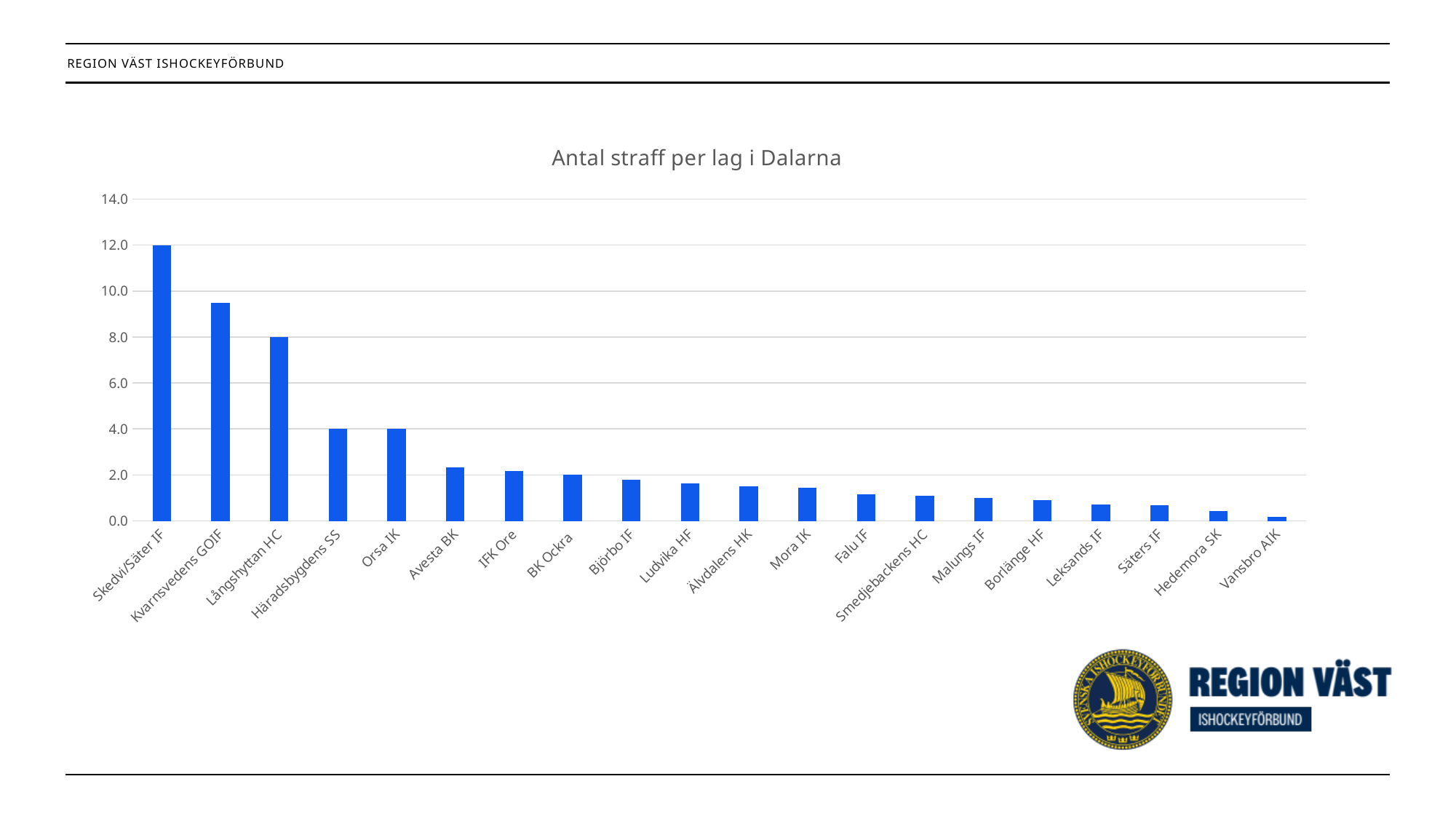
What is the value for Långshyttan HC? 8.0 Which team has the highest value in the chart? Skedvi/Säter IF What kind of chart is shown on the slide? bar chart Which team has the lowest value in the chart? Vansbro AIK Is the value for Kvarnsvedens GOIF greater or less than 10.0? less How many teams are shown on the x axis of the chart? 20 Do the values rise or fall from left to right along the x axis? fall Is the value for Avesta BK greater or less than 2.0? greater What is the value for Skedvi/Säter IF? 12.0 Is the value for Mora IK greater or less than 2.0? less Which has a larger value, Kvarnsvedens GOIF or Långshyttan HC? Kvarnsvedens GOIF What is the title of the chart? Antal straff per lag i Dalarna